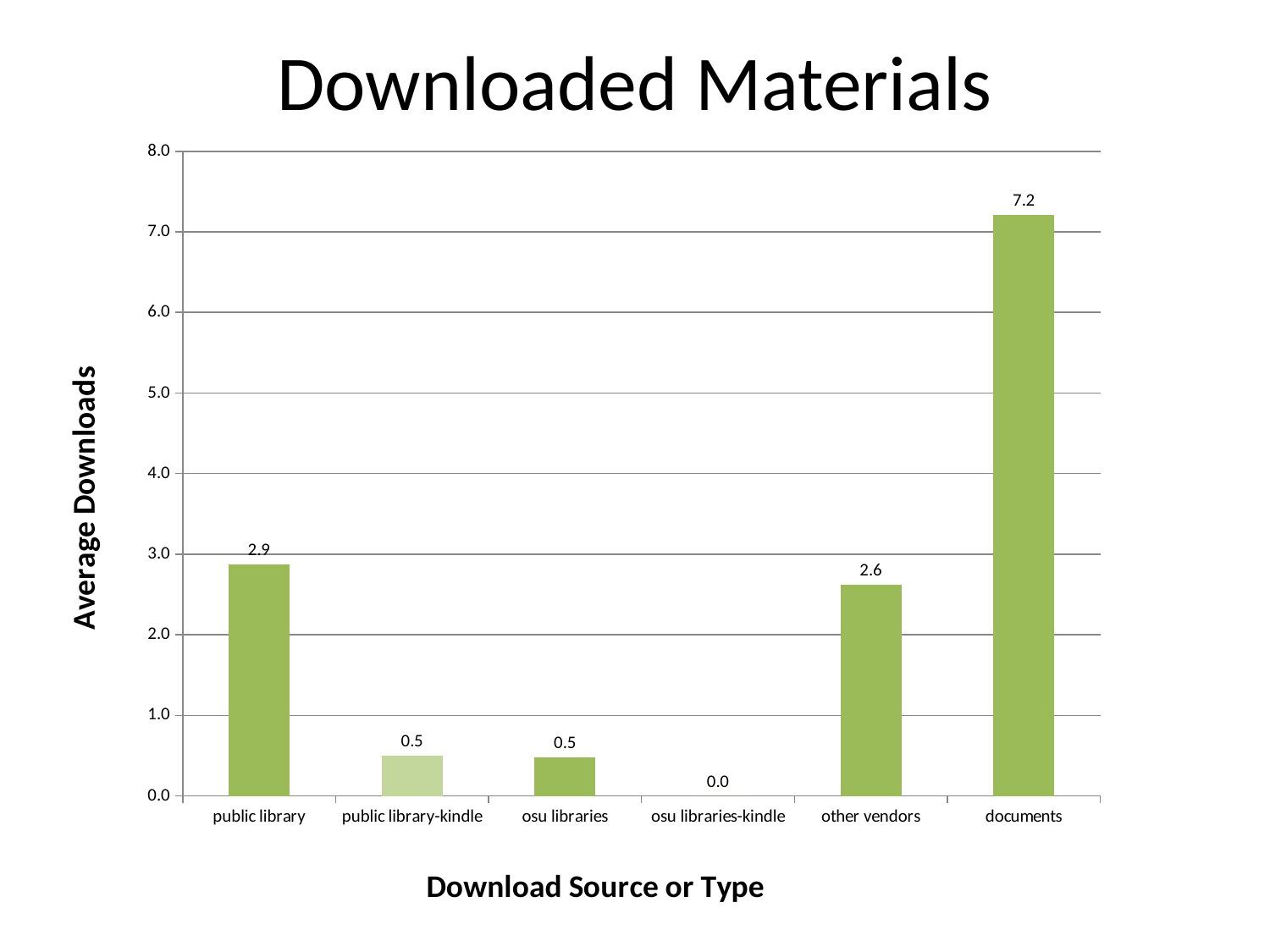
What is the average downloads value for other vendors? 2.6 What is the average downloads value for documents? 7.2 What is the average downloads value for osu libraries-kindle? 0.0 How many download source or type categories are shown on the chart? 6 What is the title of the chart? Downloaded Materials Is the value for documents greater or less than 7.0? greater What is the difference in average downloads between documents and public library? 4.3 What is the average downloads value for public library? 2.9 Which has higher average downloads, public library or other vendors? public library Which download source or type has the lowest average downloads? osu libraries-kindle Which download source or type has the highest average downloads? documents What kind of chart is shown on the slide? bar chart